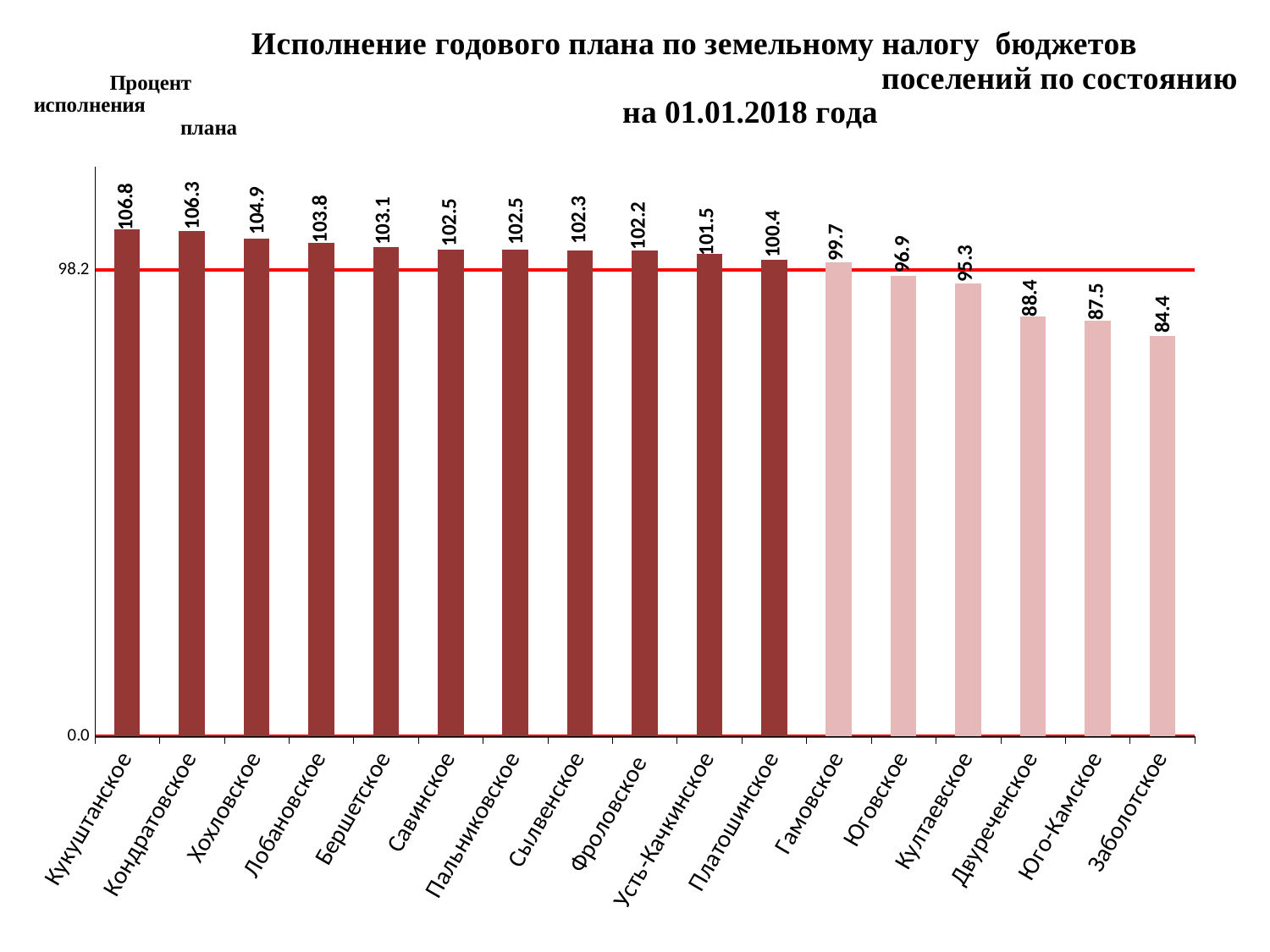
What is the value for Гамовское? 99.7 What value is marked by the horizontal red line on the chart? 98.2 What is the value for Заболотское? 84.4 What is the difference between the values for Кукуштанское and Заболотское? 22.4 Which settlement has the highest value? Кукуштанское What type of chart is shown on the slide? bar chart What is the difference between the values for Двуреченское and Юго-Камское? 0.9 Do the values rise or fall from left to right along the x axis? fall Which is larger, the value for Юговское or the value for Култаевское? Юговское How many settlements are shown on the chart? 17 Which settlement has the lowest value? Заболотское What is the value for Кукуштанское? 106.8